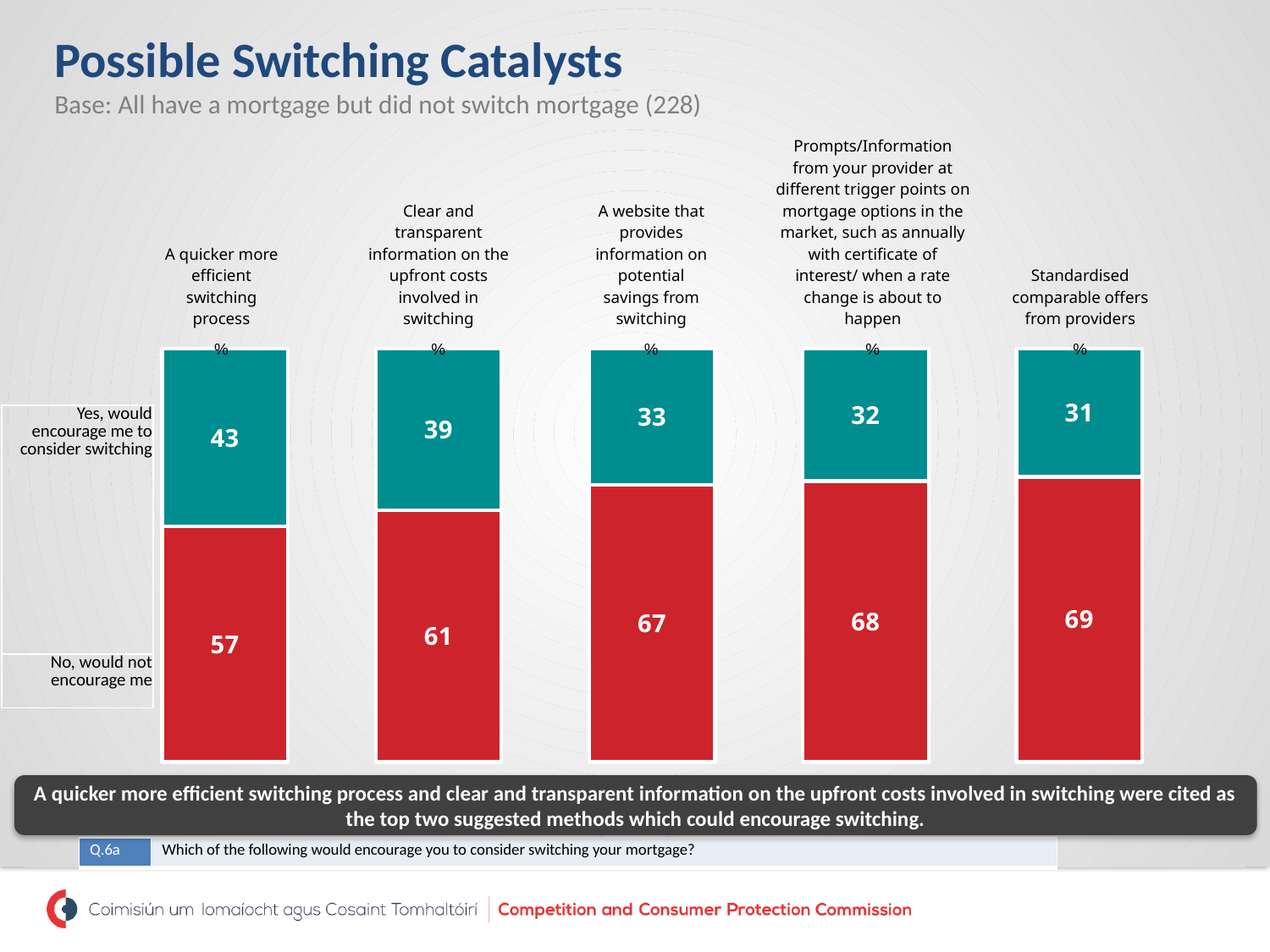
How many series does the chart show? 2 Which catalyst has the highest 'Yes, would encourage me to consider switching' value? A quicker more efficient switching process What is the 'Yes, would encourage me to consider switching' value for a website that provides information on potential savings from switching? 33 Which catalyst has the lowest 'Yes, would encourage me to consider switching' value? Standardised comparable offers from providers Which colour represents 'No, would not encourage me' in the chart? Red What percentage said a quicker more efficient switching process would encourage them to consider switching? 43 How many switching catalysts are shown in the chart? 5 What is the value for 'No, would not encourage me' for standardised comparable offers from providers? 69 What is the difference between the 'No' and 'Yes' values for clear and transparent information on the upfront costs involved in switching? 22 Which is larger: the 'Yes' value for a quicker more efficient switching process or the 'Yes' value for prompts/information from your provider at different trigger points? A quicker more efficient switching process What is the total of the stacked bar for prompts/information from your provider at different trigger points? 100 What type of chart is shown on the slide? Stacked bar chart